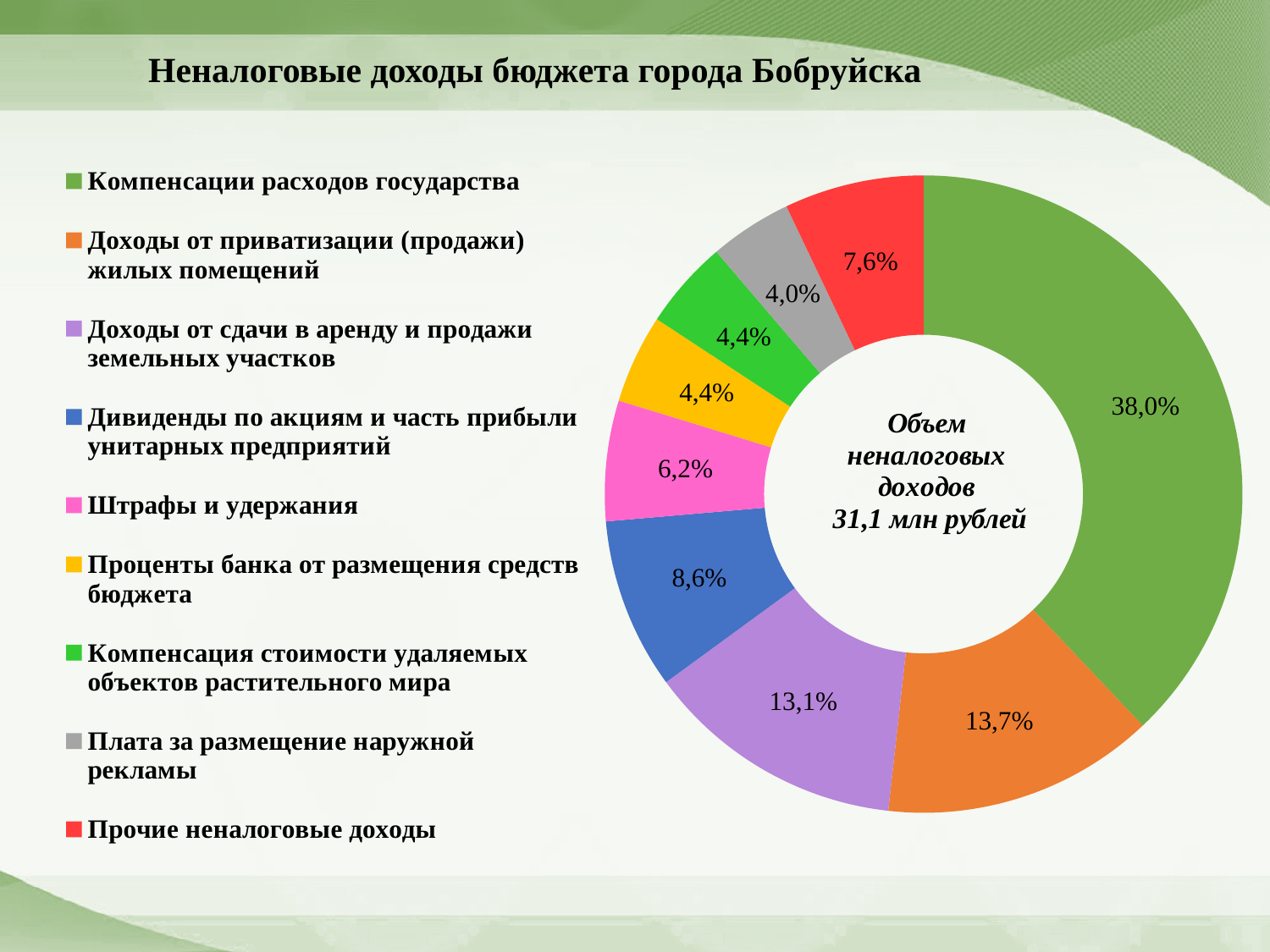
Какую долю составляют «Доходы от приватизации (продажи) жилых помещений»? 13,7% Каким цветом на диаграмме обозначены «Штрафы и удержания»? Розовым Какую долю составляет «Плата за размещение наружной рекламы»? 4,0% Какой тип диаграммы показан на слайде? Кольцевая (круговая) диаграмма Какой общий объем неналоговых доходов указан в центре диаграммы? 31,1 млн рублей Какая категория имеет наименьшую долю на диаграмме? Плата за размещение наружной рекламы На сколько процентных пунктов доля «Доходов от приватизации (продажи) жилых помещений» больше доли «Доходов от сдачи в аренду и продажи земельных участков»? 0,6 Сколько категорий показано на диаграмме? 9 Какую долю составляют «Штрафы и удержания»? 6,2% Какая категория имеет наибольшую долю на диаграмме? Компенсации расходов государства Какую долю составляют «Компенсации расходов государства» на диаграмме? 38,0% Что больше: доля «Дивидендов по акциям и части прибыли унитарных предприятий» или доля «Прочих неналоговых доходов»? Дивиденды по акциям и часть прибыли унитарных предприятий